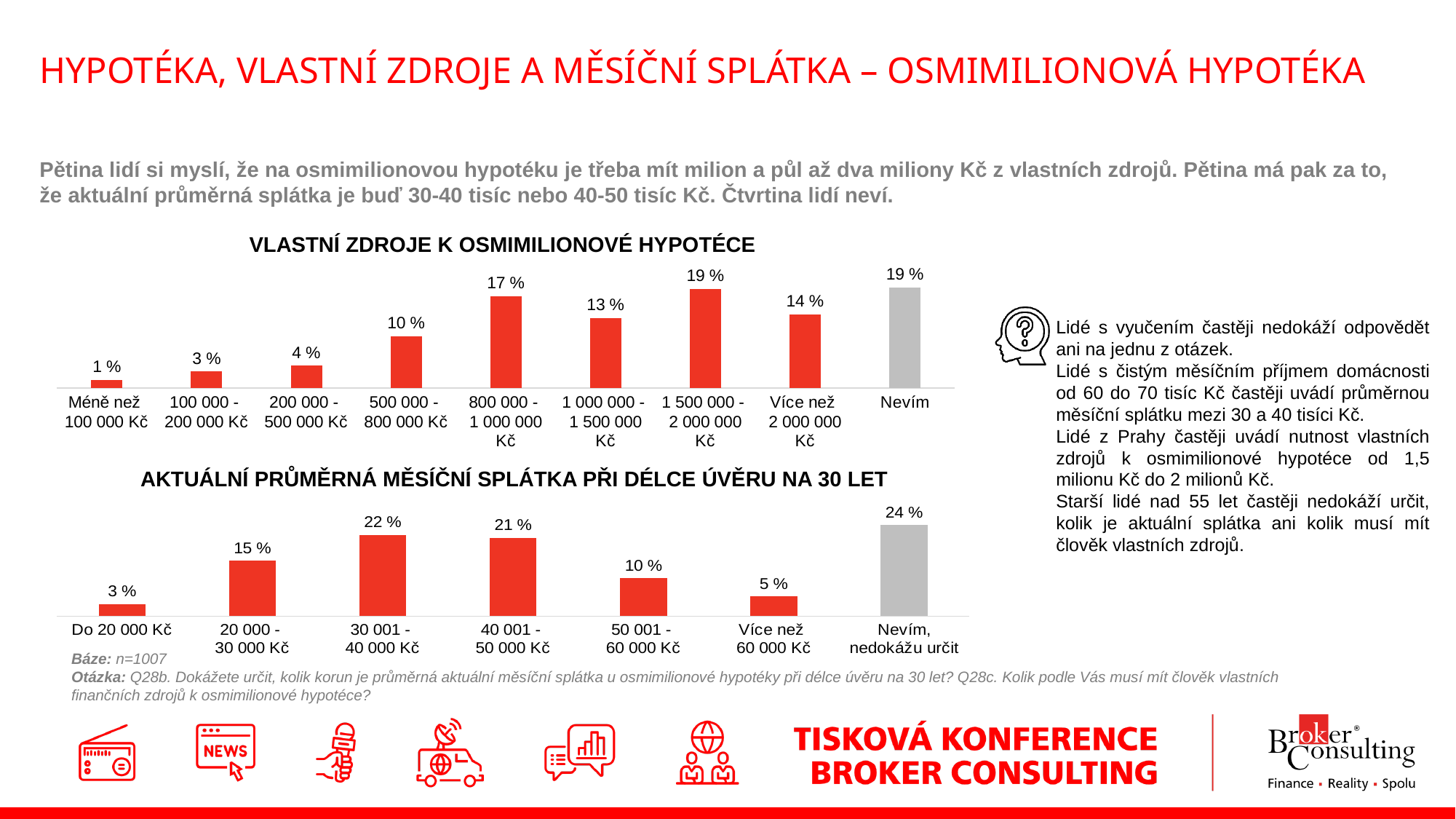
In the chart 'VLASTNÍ ZDROJE K OSMIMILIONOVÉ HYPOTÉCE', what is the value for 'Více než 2 000 000 Kč'? 14 % In the chart 'AKTUÁLNÍ PRŮMĚRNÁ MĚSÍČNÍ SPLÁTKA PŘI DÉLCE ÚVĚRU NA 30 LET', which category has the highest value? Nevím, nedokážu určit In the chart 'AKTUÁLNÍ PRŮMĚRNÁ MĚSÍČNÍ SPLÁTKA PŘI DÉLCE ÚVĚRU NA 30 LET', what is the difference between '20 000 - 30 000 Kč' and 'Více než 60 000 Kč'? 10 % In the chart 'VLASTNÍ ZDROJE K OSMIMILIONOVÉ HYPOTÉCE', how many categories are shown? 9 In the chart 'AKTUÁLNÍ PRŮMĚRNÁ MĚSÍČNÍ SPLÁTKA PŘI DÉLCE ÚVĚRU NA 30 LET', how many categories are shown? 7 In the chart 'AKTUÁLNÍ PRŮMĚRNÁ MĚSÍČNÍ SPLÁTKA PŘI DÉLCE ÚVĚRU NA 30 LET', which category has the lowest value? Do 20 000 Kč In the chart 'AKTUÁLNÍ PRŮMĚRNÁ MĚSÍČNÍ SPLÁTKA PŘI DÉLCE ÚVĚRU NA 30 LET', what is the value for '30 001 - 40 000 Kč'? 22 % In the chart 'VLASTNÍ ZDROJE K OSMIMILIONOVÉ HYPOTÉCE', what is the difference between '1 500 000 - 2 000 000 Kč' and '1 000 000 - 1 500 000 Kč'? 6 % In the chart 'VLASTNÍ ZDROJE K OSMIMILIONOVÉ HYPOTÉCE', what is the value for '800 000 - 1 000 000 Kč'? 17 % In the chart 'VLASTNÍ ZDROJE K OSMIMILIONOVÉ HYPOTÉCE', which is larger: '500 000 - 800 000 Kč' or '200 000 - 500 000 Kč'? 500 000 - 800 000 Kč In the chart 'VLASTNÍ ZDROJE K OSMIMILIONOVÉ HYPOTÉCE', which category has the lowest value? Méně než 100 000 Kč What type of chart is 'AKTUÁLNÍ PRŮMĚRNÁ MĚSÍČNÍ SPLÁTKA PŘI DÉLCE ÚVĚRU NA 30 LET'? Bar chart